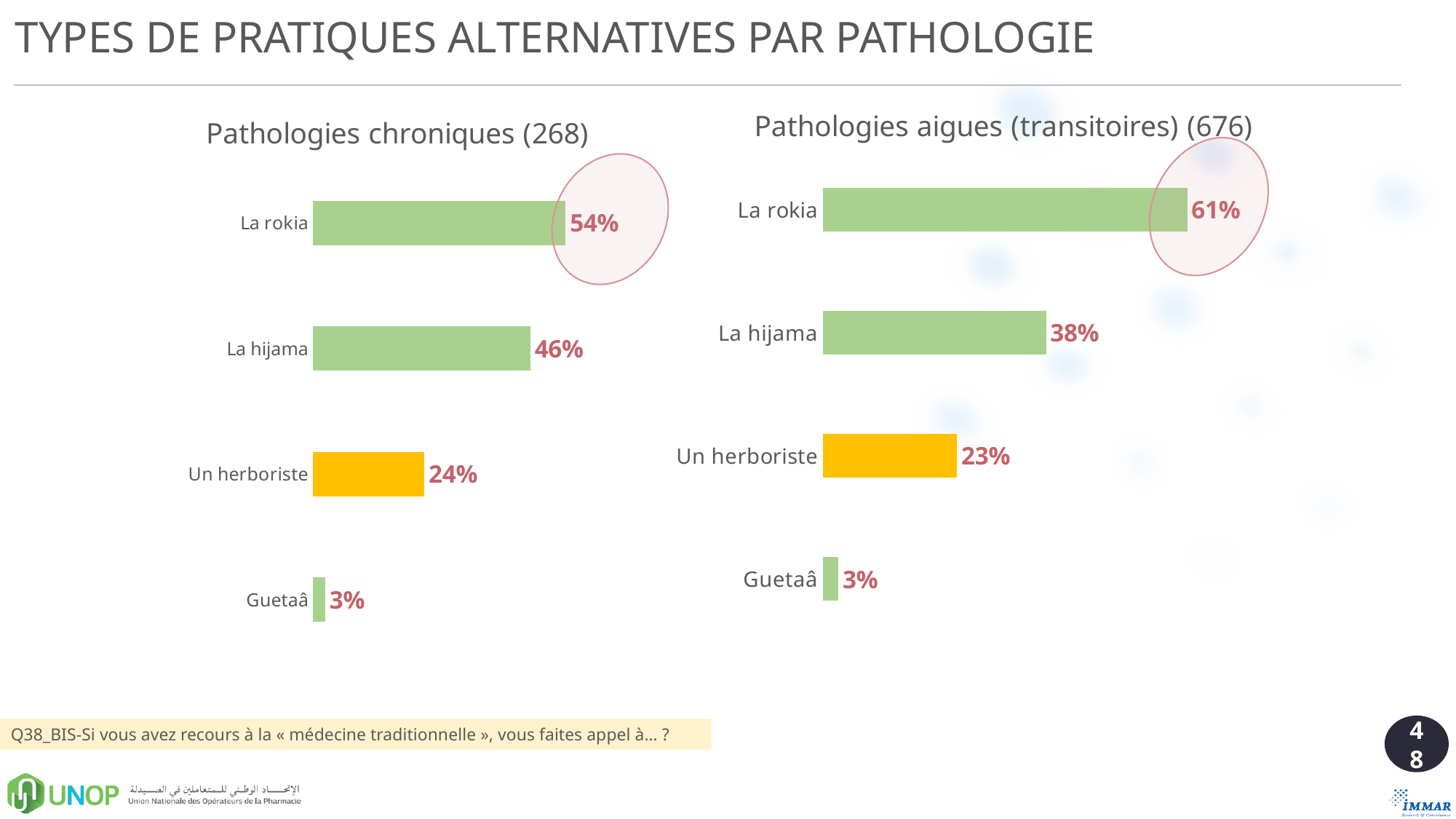
How many categories are shown in the 'Pathologies chroniques (268)' chart? 4 In the 'Pathologies aigues (transitoires) (676)' chart, what is the difference between La rokia and Un herboriste? 38% In the 'Pathologies chroniques (268)' chart, which category has the highest value? La rokia In the 'Pathologies chroniques (268)' chart, which category's bar is coloured yellow instead of green? Un herboriste In the 'Pathologies aigues (transitoires) (676)' chart, what is the value for Un herboriste? 23% In the 'Pathologies chroniques (268)' chart, what is the value for La rokia? 54% In the 'Pathologies chroniques (268)' chart, which is larger: Un herboriste or Guetaâ? Un herboriste What type of chart is the 'Pathologies aigues (transitoires) (676)' chart? Bar chart In the 'Pathologies aigues (transitoires) (676)' chart, what is the value for La hijama? 38% In the 'Pathologies chroniques (268)' chart, what is the difference between La rokia and La hijama? 8% Which is larger: La rokia in the 'Pathologies chroniques (268)' chart or La rokia in the 'Pathologies aigues (transitoires) (676)' chart? Pathologies aigues (transitoires) (676) In the 'Pathologies aigues (transitoires) (676)' chart, which category has the lowest value? Guetaâ